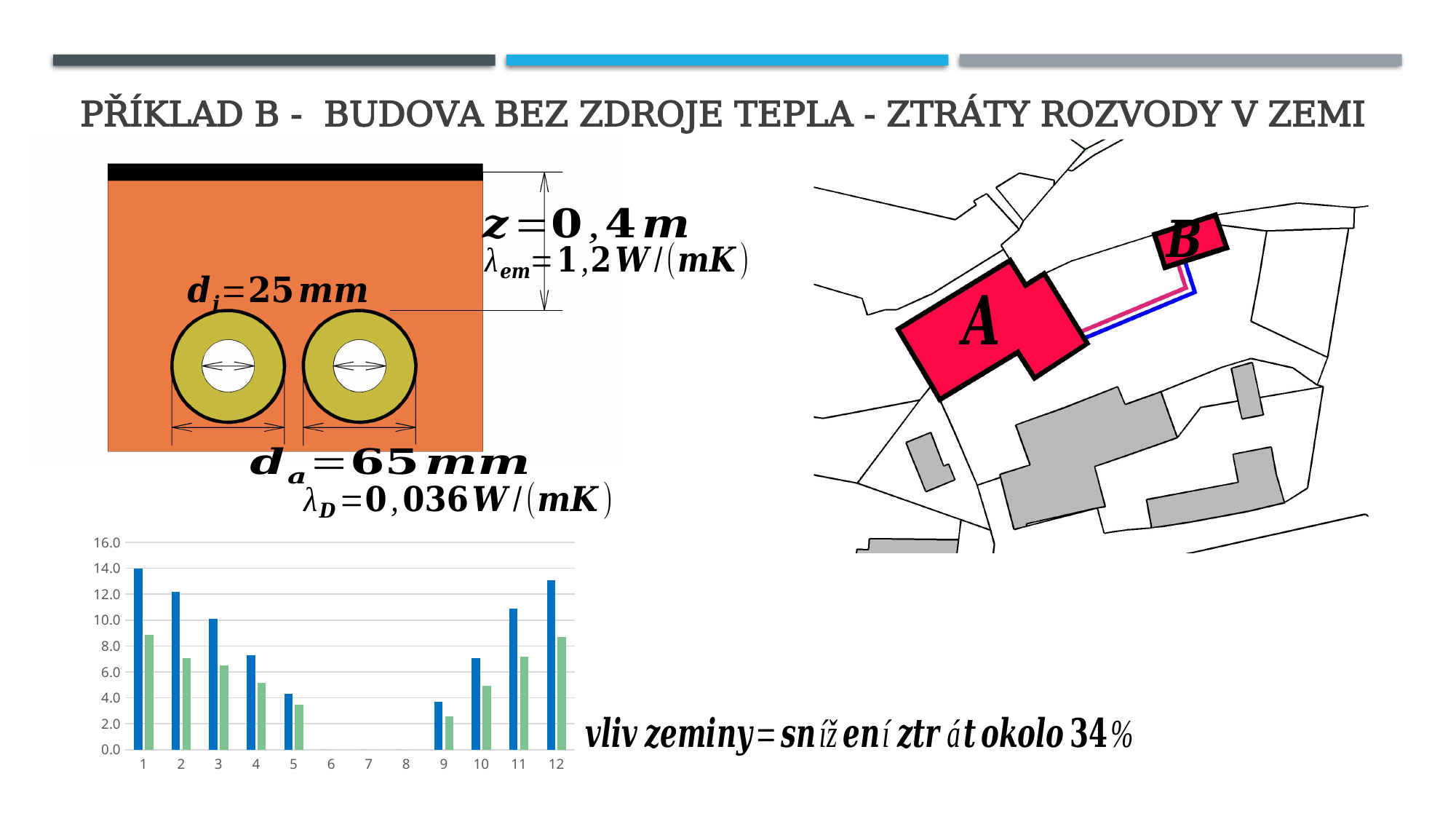
In the bar chart, is the blue bar for category 11 greater or less than 10.0? greater In the bar chart, for category 2, which bar is taller, the blue one or the green one? the blue one Which categories in the bar chart have no bars at all? 6, 7 and 8 In the bar chart, which category has the tallest blue bar? 1 In the bar chart, is the blue bar for category 1 greater or less than 12.0? greater In the bar chart, is the blue bar for category 5 greater or less than 6.0? less What kind of chart is shown at the bottom left of the slide? bar chart In the bar chart, do the blue bars rise or fall from category 1 to category 5? fall How many categories are shown on the x axis of the bar chart? 12 In the bar chart, do the blue bars rise or fall from category 9 to category 12? rise